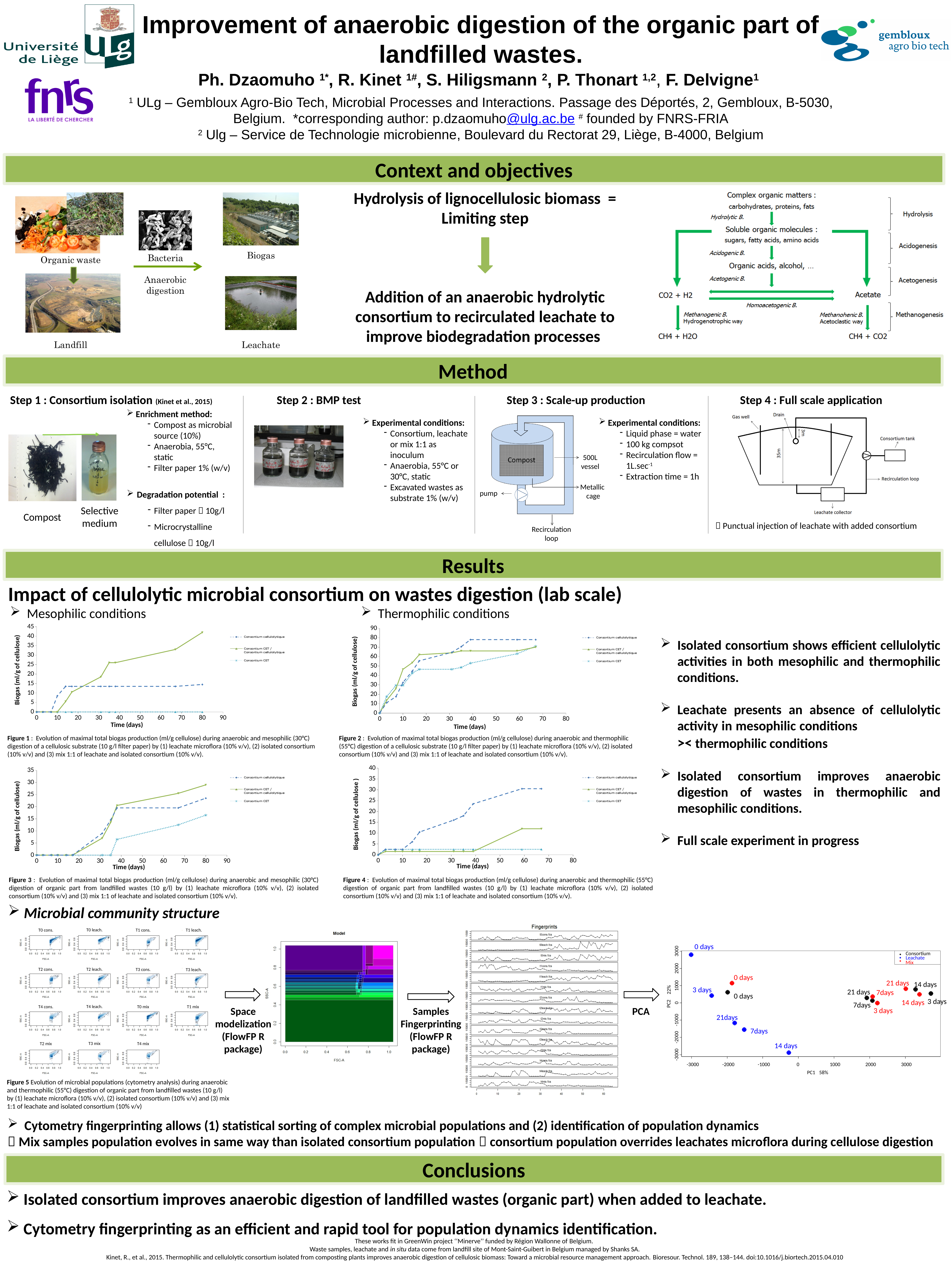
In Figure 1, is the value for Consortium CET / Consortium cellulolytique at day 80 greater or less than 35? greater In Figure 1, is the value for Consortium CET at day 80 greater or less than 5? less In Figure 3, is the value for Consortium CET at day 80 greater or less than 20? less In Figure 3 (mesophilic, landfilled wastes), does the Consortium CET / Consortium cellulolytique series rise or fall over time? rise In Figure 4, which is larger at day 60: Consortium cellulolytique or Consortium CET? Consortium cellulolytique How many series does the legend of Figure 1 list? 3 What kind of chart is Figure 1 (mesophilic conditions, top left)? line chart In the PCA plot, what percentage of variance is shown for PC1? 58% In Figure 1, which series reaches the highest biogas value at day 80? Consortium CET / Consortium cellulolytique How many groups does the legend of the PCA plot list? 3